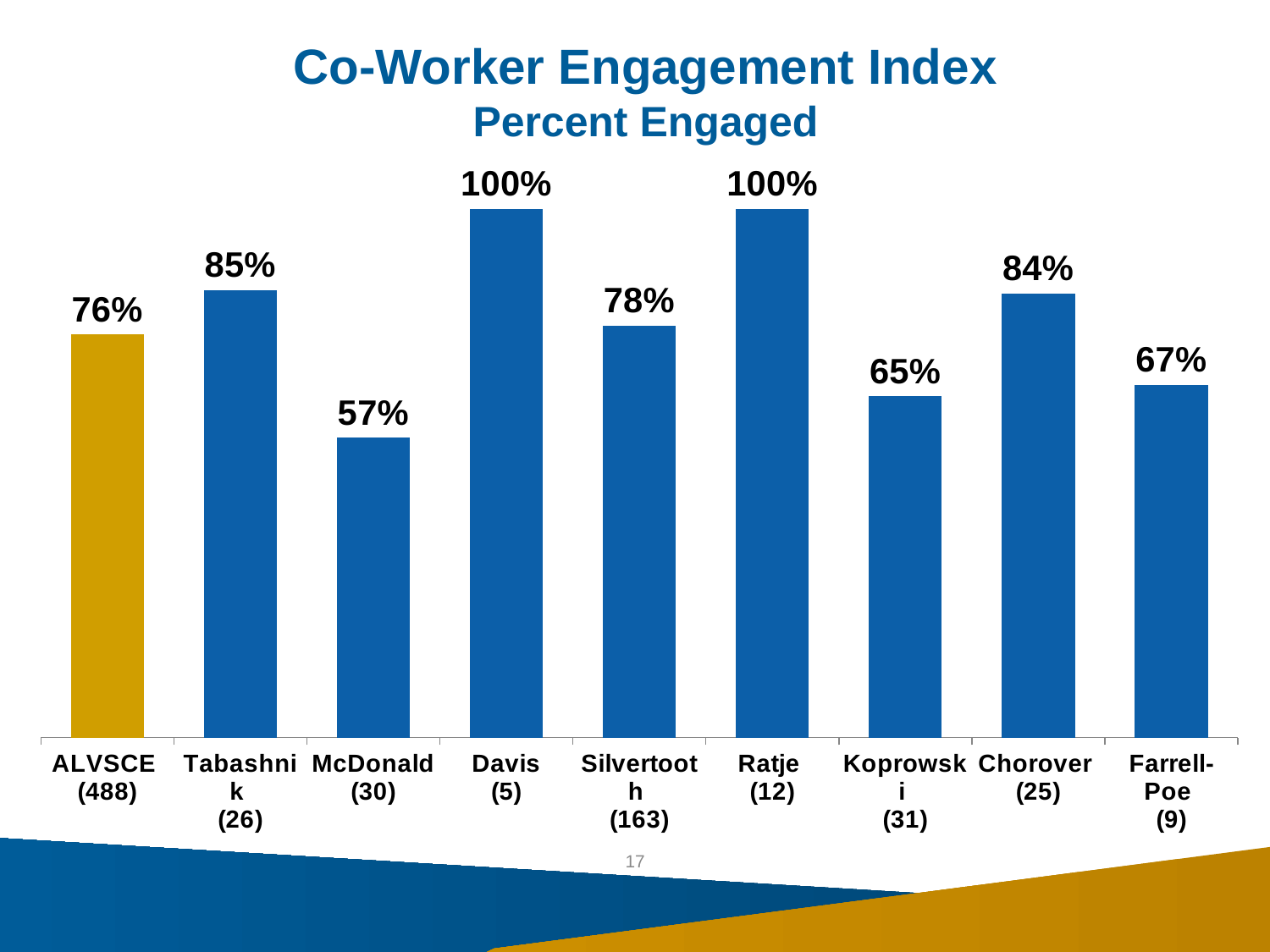
What kind of chart is shown on the slide? Bar chart What is the percent engaged for Chorover (25)? 84% Which bar is coloured differently (gold) from the others? ALVSCE (488) What is the difference in percent engaged between Tabashnik (26) and Farrell-Poe (9)? 18% Which has a higher percent engaged, Silvertooth (163) or Koprowski (31)? Silvertooth (163) Which categories share the highest percent engaged value of 100%? Davis (5) and Ratje (12) What is the title of the chart? Co-Worker Engagement Index What is the percent engaged for McDonald (30)? 57% How many categories are shown in the chart? 9 Which category has the lowest percent engaged? McDonald (30) What is the percent engaged for Koprowski (31)? 65% What is the percent engaged for ALVSCE (488)? 76%